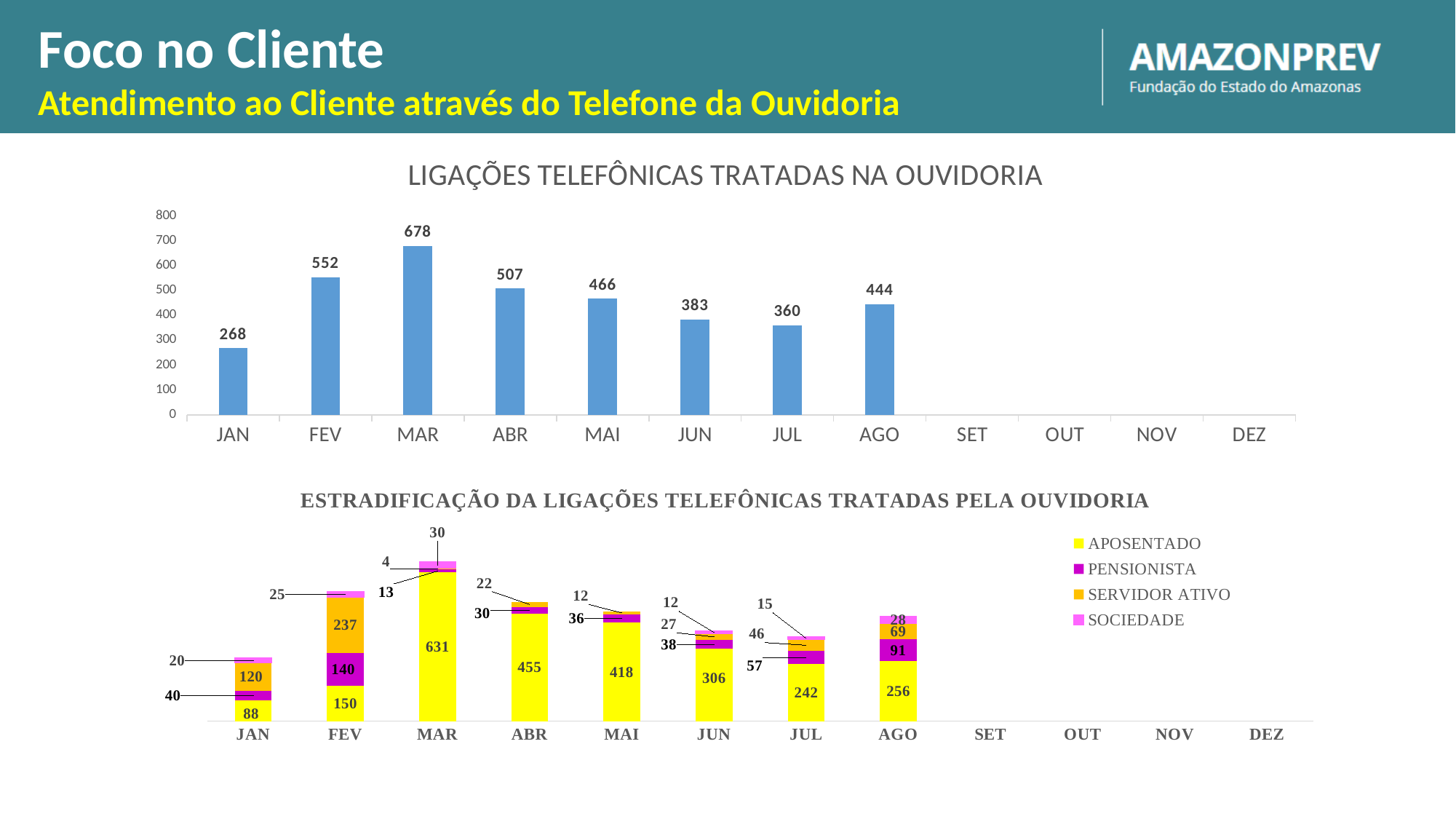
In the chart 'LIGAÇÕES TELEFÔNICAS TRATADAS NA OUVIDORIA', what is the difference between FEV and JUL? 192 In the bottom chart 'ESTRADIFICAÇÃO DA LIGAÇÕES TELEFÔNICAS TRATADAS PELA OUVIDORIA', what is the total of the stacked bar for AGO? 444 In the bottom chart 'ESTRADIFICAÇÃO DA LIGAÇÕES TELEFÔNICAS TRATADAS PELA OUVIDORIA', which colour represents SOCIEDADE? Pink In the chart 'LIGAÇÕES TELEFÔNICAS TRATADAS NA OUVIDORIA', what is the value for MAR? 678 In the chart 'LIGAÇÕES TELEFÔNICAS TRATADAS NA OUVIDORIA', how many months have a bar plotted? 8 In the chart 'LIGAÇÕES TELEFÔNICAS TRATADAS NA OUVIDORIA', which month has the highest value? MAR In the chart 'LIGAÇÕES TELEFÔNICAS TRATADAS NA OUVIDORIA', which is larger, ABR or AGO? ABR In the bottom chart 'ESTRADIFICAÇÃO DA LIGAÇÕES TELEFÔNICAS TRATADAS PELA OUVIDORIA', what is the APOSENTADO value for MAR? 631 In the bottom chart 'ESTRADIFICAÇÃO DA LIGAÇÕES TELEFÔNICAS TRATADAS PELA OUVIDORIA', how many series does the legend list? 4 What kind of chart is 'LIGAÇÕES TELEFÔNICAS TRATADAS NA OUVIDORIA'? Bar chart In the bottom chart 'ESTRADIFICAÇÃO DA LIGAÇÕES TELEFÔNICAS TRATADAS PELA OUVIDORIA', what is the SERVIDOR ATIVO value for FEV? 237 In the chart 'LIGAÇÕES TELEFÔNICAS TRATADAS NA OUVIDORIA', which month has the lowest value? JAN